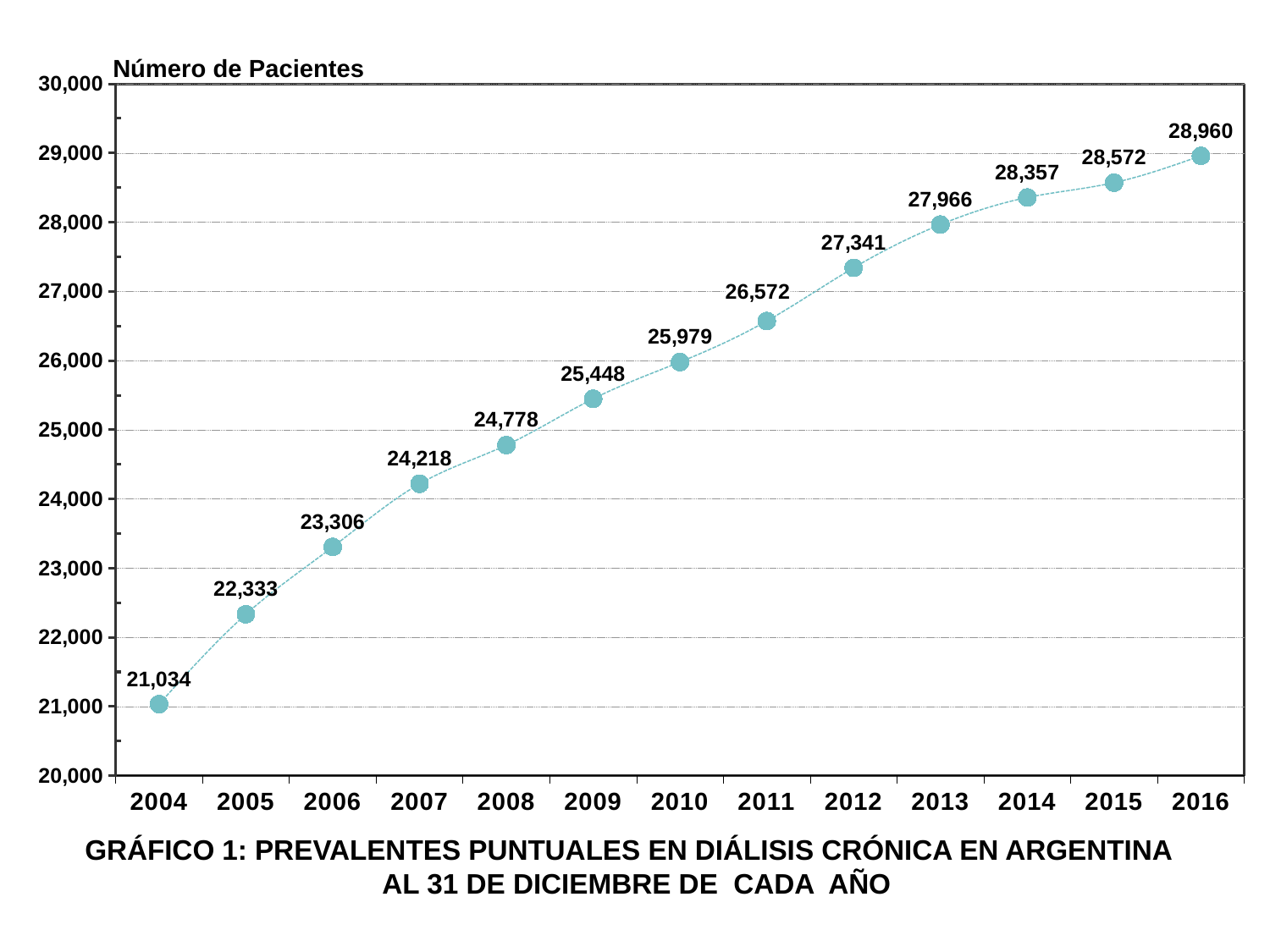
Does the number of patients rise or fall from 2004 to 2016? rise What is the number of patients in 2010? 25,979 What is the number of patients in 2013? 27,966 What is the difference in the number of patients between 2005 and 2004? 1,299 What is the difference in the number of patients between 2016 and 2015? 388 Which year has more patients, 2008 or 2011? 2011 Which year has the highest number of patients? 2016 Which year has the lowest number of patients? 2004 How many years are plotted on the chart? 13 What kind of chart is shown? line chart What is the number of patients in 2004? 21,034 Is the value for 2012 greater or less than 27,000? greater